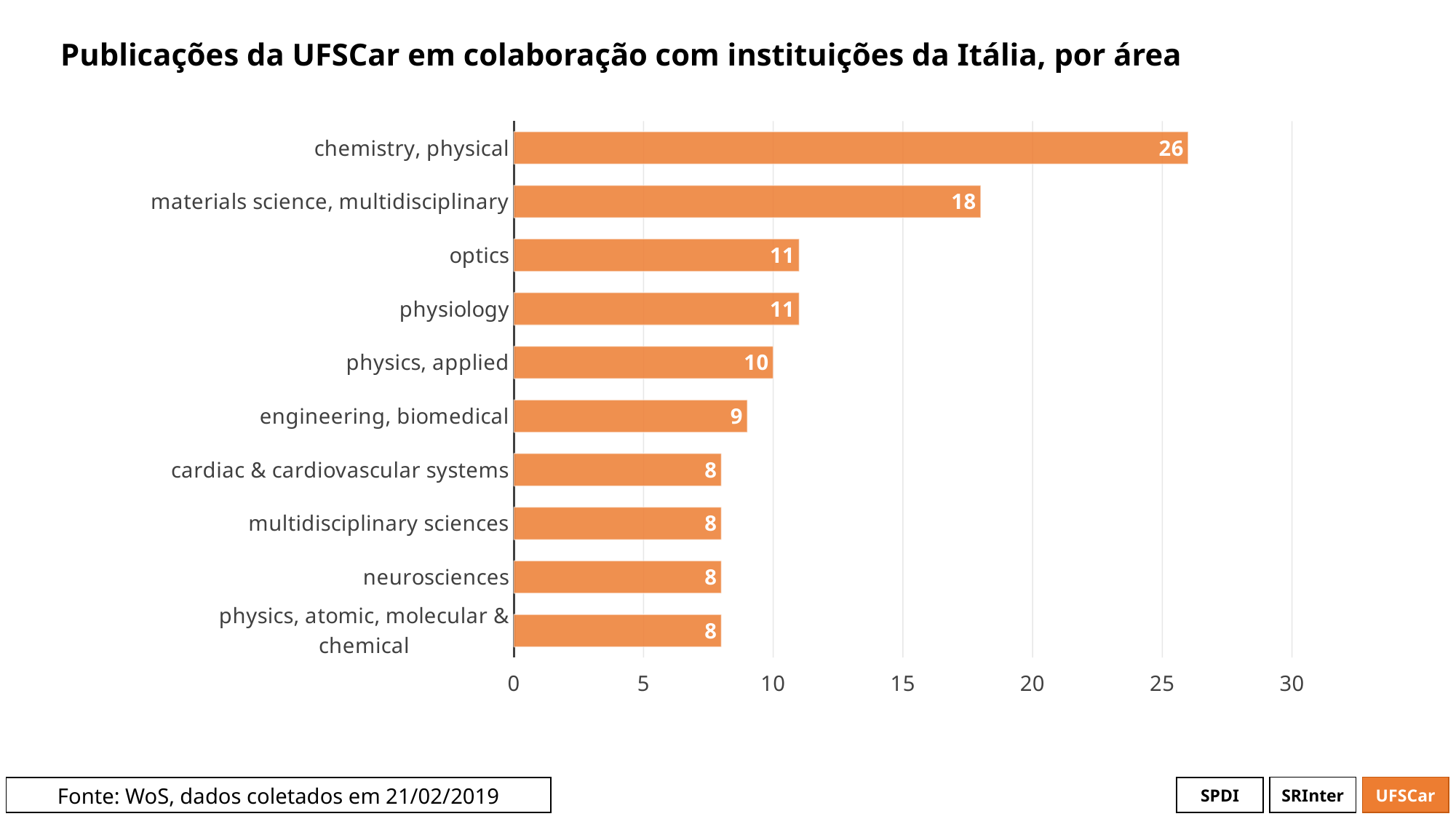
What is the value for chemistry, physical? 26 What kind of chart is shown on the slide? bar chart What is the value for engineering, biomedical? 9 What is the difference between chemistry, physical and materials science, multidisciplinary? 8 Which is larger, physics, applied or engineering, biomedical? physics, applied What is the difference between optics and neurosciences? 3 What is the title of the chart? Publicações da UFSCar em colaboração com instituições da Itália, por área How many areas are shown in the chart? 10 Is the value for materials science, multidisciplinary greater or less than 15? greater Which area has the highest value? chemistry, physical What is the value for materials science, multidisciplinary? 18 What is the value for physics, applied? 10